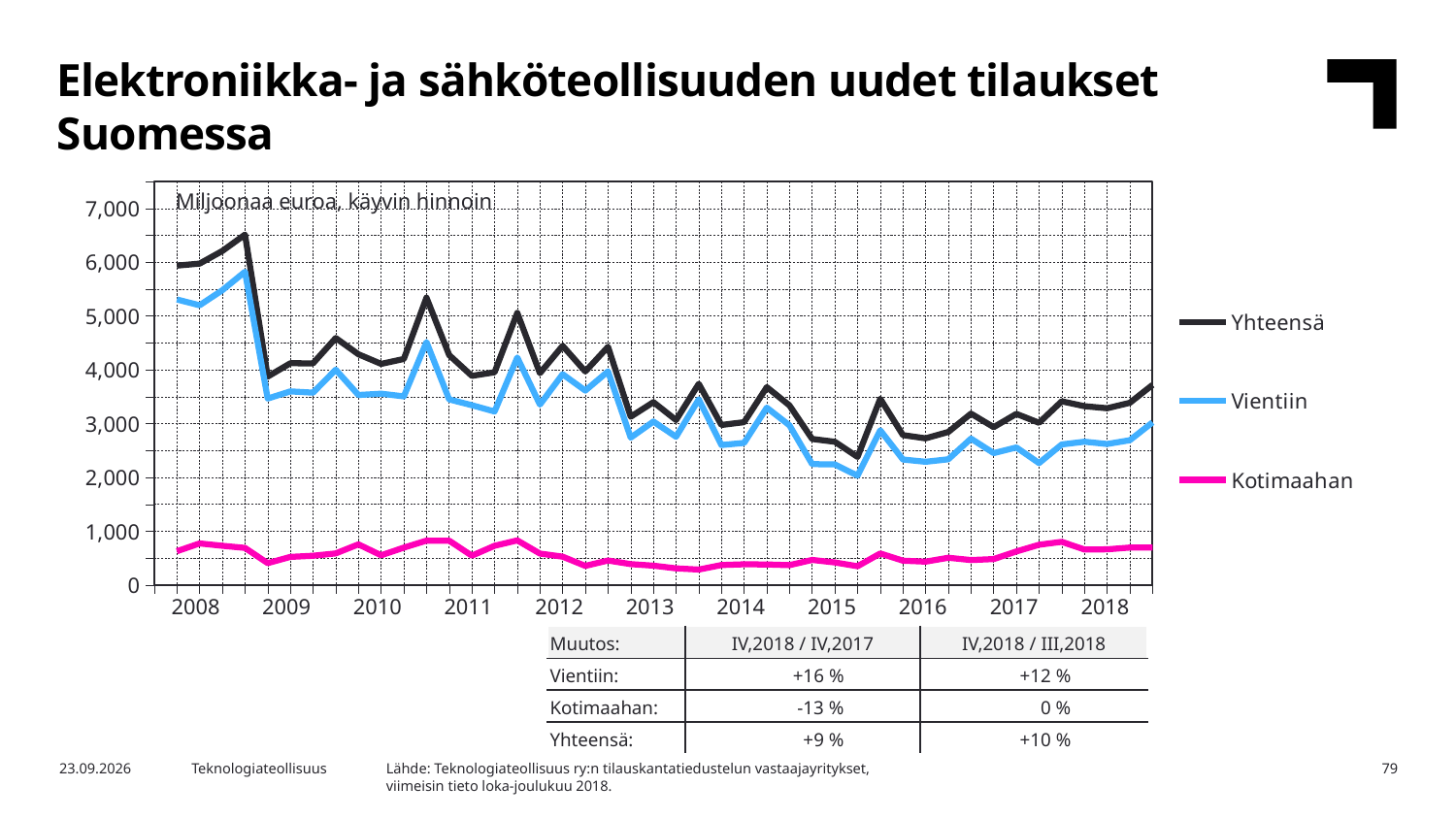
How many series does the legend list? 3 Is the peak value of Yhteensä in 2008 greater or less than 6,000? greater How many years are labelled on the x axis? 11 What type of chart is shown on the slide? line chart Which series has the lowest values throughout the chart? Kotimaahan What unit is stated for the values in the chart? Miljoonaa euroa, käyvin hinnoin Which series has the highest values throughout the chart? Yhteensä Is the value for Yhteensä in 2016 greater or less than 4,000? less Is the Vientiin line or the Kotimaahan line higher in 2018? Vientiin Which series are listed in the legend? Yhteensä, Vientiin, Kotimaahan Is the value for Kotimaahan in 2010 greater or less than 1,000? less Does the Yhteensä line overall rise or fall from 2008 to 2018? fall